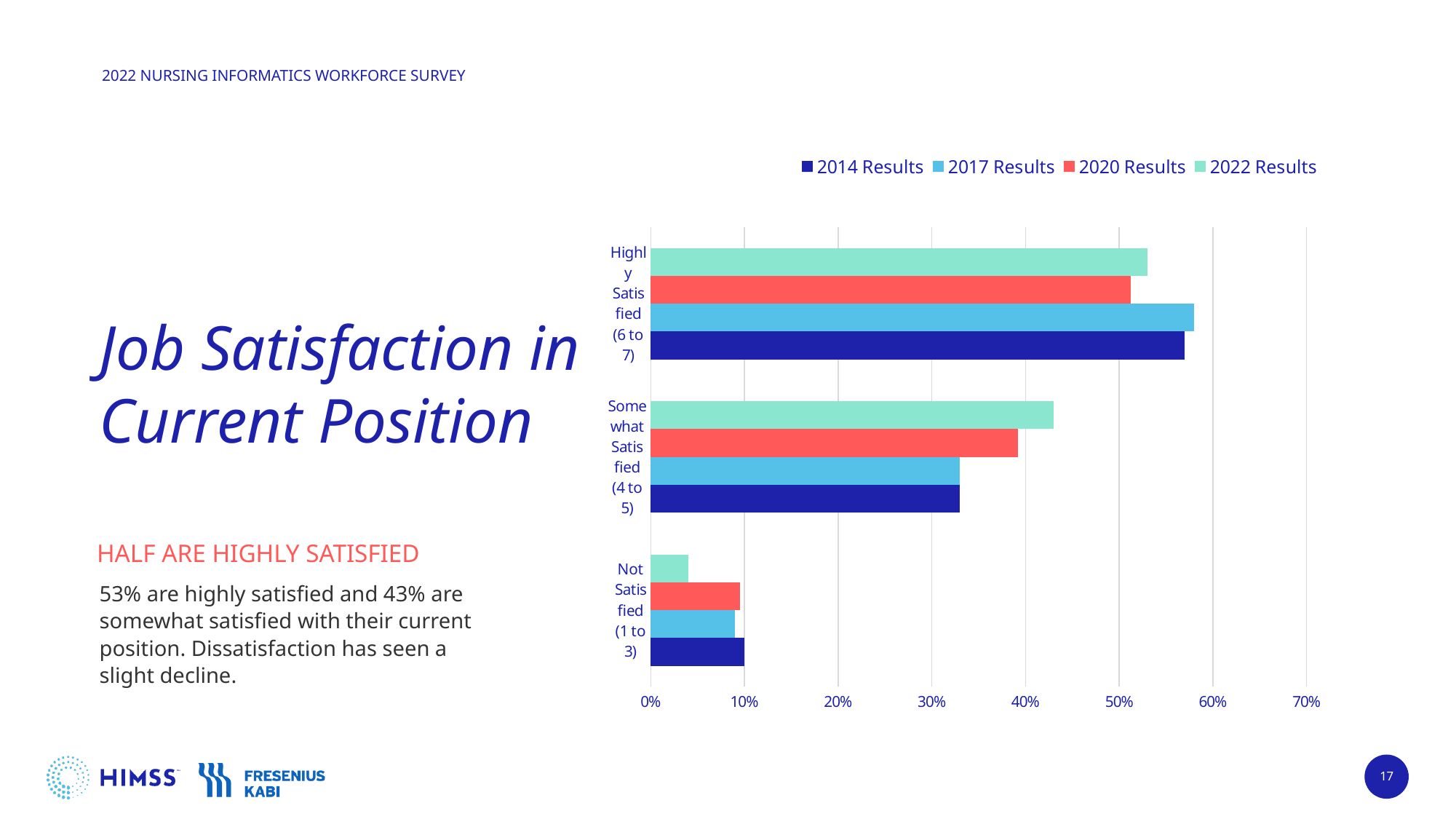
Which survey year has the lowest value for Not Satisfied (1 to 3)? 2022 Results Which survey year has the highest value for Somewhat Satisfied (4 to 5)? 2022 Results What kind of chart is shown on the slide? bar chart Is the 2022 Results value for Not Satisfied (1 to 3) greater or less than 10%? less According to the slide, what share of respondents were Highly Satisfied (6 to 7) in the 2022 Results? 53% For Not Satisfied (1 to 3), which is larger: the 2014 Results or the 2022 Results? 2014 Results According to the slide, what share of respondents were Somewhat Satisfied (4 to 5) in the 2022 Results? 43% How many series does the chart legend list? 4 How many satisfaction categories are plotted on the chart? 3 Is the 2017 Results value for Highly Satisfied (6 to 7) greater or less than 50%? greater Is the 2017 Results value for Somewhat Satisfied (4 to 5) greater or less than 30%? greater For Highly Satisfied (6 to 7), which is larger: the 2017 Results or the 2020 Results? 2017 Results